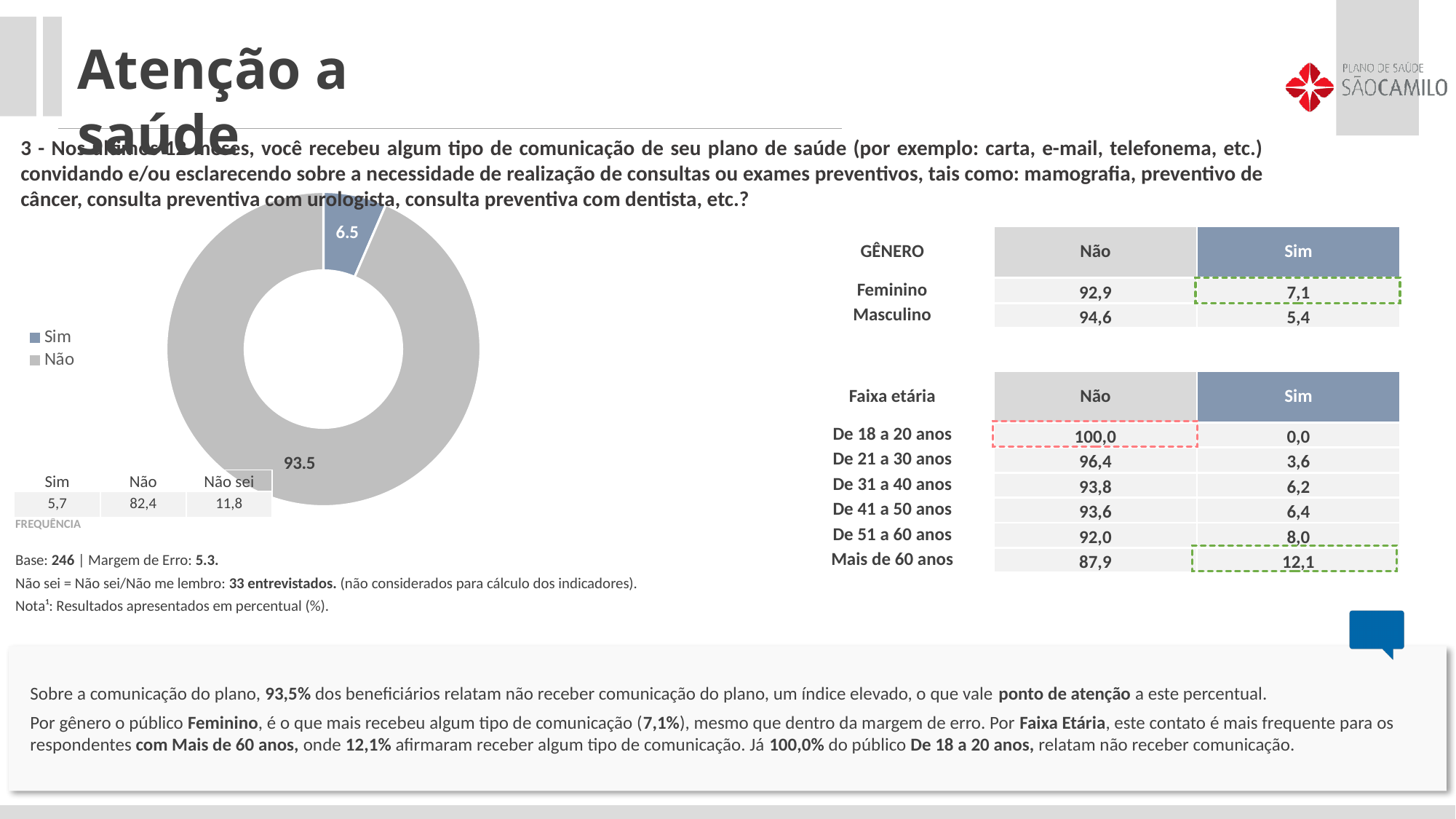
What colour is the "Sim" slice in the donut chart? Blue What type of chart is shown on the left of the slide? Pie (donut) chart How many slices does the donut chart have? 2 What is the total of the two values shown in the donut chart? 100.0 What value does the donut chart show for "Sim"? 6.5 What value does the donut chart show for "Não"? 93.5 Which category has the smallest slice in the donut chart? Sim Which category has the largest slice in the donut chart? Não What share of the donut chart does the "Não" slice represent? 93.5% How many entries does the legend of the donut chart list? 2 What is the difference between the "Não" and "Sim" values in the donut chart? 87.0 In the donut chart, which is larger: "Sim" or "Não"? Não